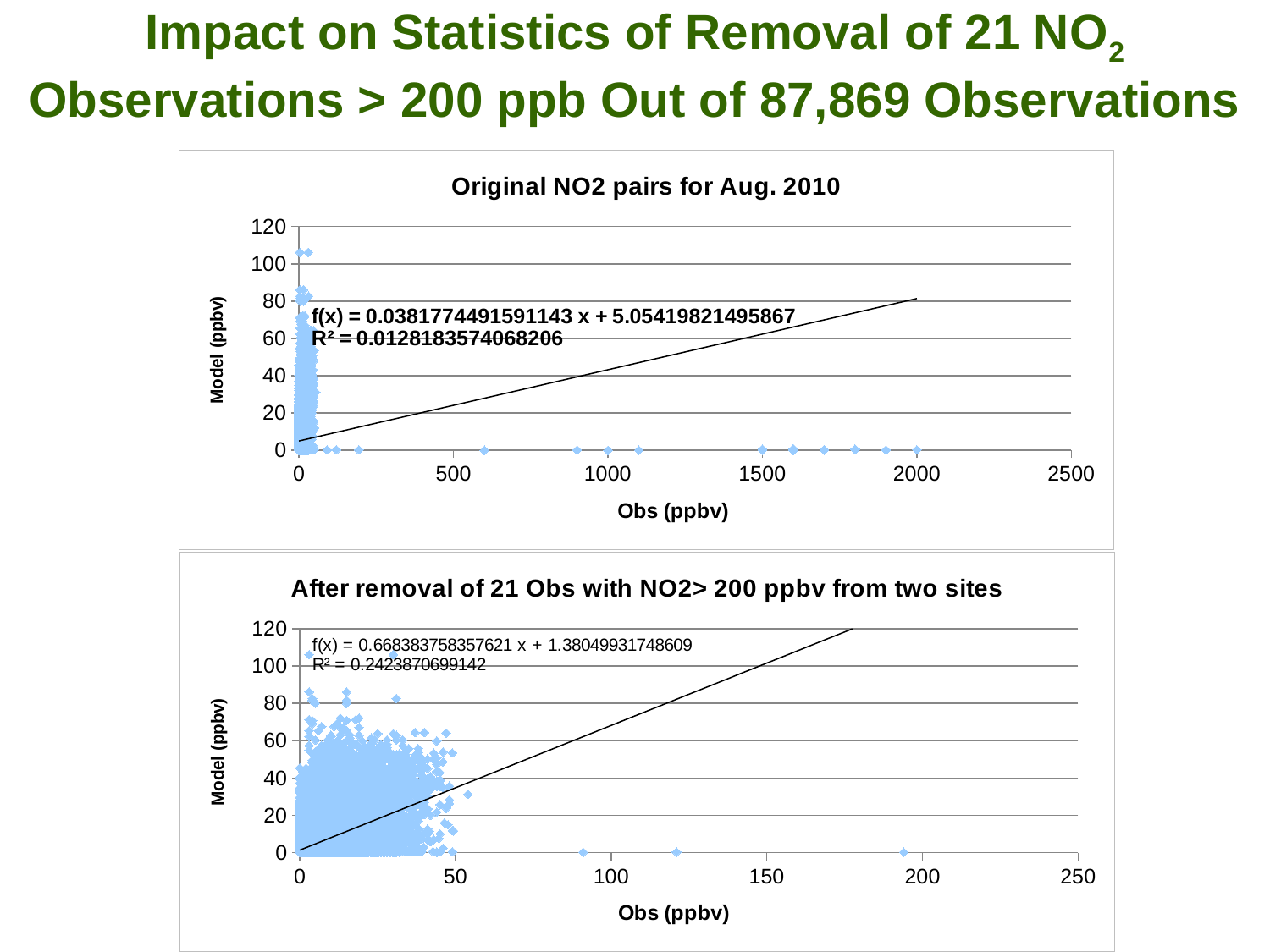
What kind of chart is the top chart titled "Original NO2 pairs for Aug. 2010"? Scatter chart In the top chart "Original NO2 pairs for Aug. 2010", what is the highest tick value shown on the x axis? 2500 What is the title of the bottom chart? After removal of 21 Obs with NO2> 200 ppbv from two sites In the top chart "Original NO2 pairs for Aug. 2010", what is the highest tick value shown on the y axis? 120 In the bottom chart "After removal of 21 Obs with NO2> 200 ppbv from two sites", what is the trendline equation shown? f(x) = 0.668383758357621 x + 1.38049931748609 In the top chart "Original NO2 pairs for Aug. 2010", what is the trendline equation shown? f(x) = 0.0381774491591143 x + 5.05419821495867 In the bottom chart "After removal of 21 Obs with NO2> 200 ppbv from two sites", does the trendline rise or fall as Obs (ppbv) increases? Rise In the bottom chart "After removal of 21 Obs with NO2> 200 ppbv from two sites", what is the R² value shown for the trendline? 0.2423870699142 In the bottom chart "After removal of 21 Obs with NO2> 200 ppbv from two sites", what is the highest tick value shown on the x axis? 250 What is the y-axis label on the top chart "Original NO2 pairs for Aug. 2010"? Model (ppbv) In the top chart "Original NO2 pairs for Aug. 2010", what is the R² value shown for the trendline? 0.0128183574068206 Which chart has the larger R² value, the top chart "Original NO2 pairs for Aug. 2010" or the bottom chart "After removal of 21 Obs with NO2> 200 ppbv from two sites"? The bottom chart (After removal of 21 Obs with NO2> 200 ppbv from two sites)